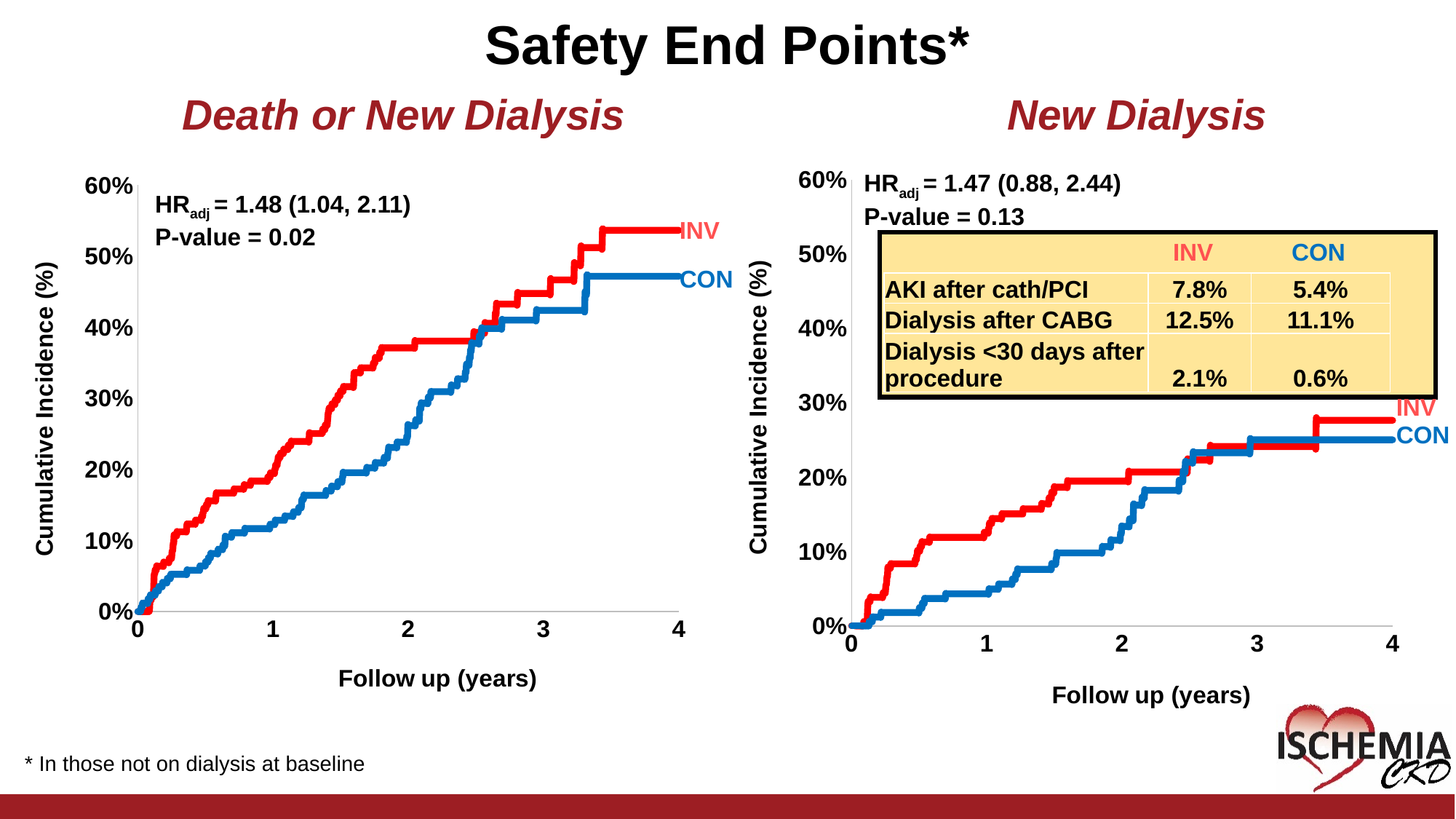
In the table on the 'New Dialysis' chart, what is the difference between INV and CON for Dialysis <30 days after procedure? 1.5% On the 'Death or New Dialysis' chart, do the curves rise or fall as follow-up years increase? rise What is the P-value shown on the 'Death or New Dialysis' chart? 0.02 In the table on the 'New Dialysis' chart, what is the INV value for AKI after cath/PCI? 7.8% How many series are plotted on the 'New Dialysis' chart? 2 On the 'Death or New Dialysis' chart, is the CON value at 4 years greater or less than 50%? less In the table on the 'New Dialysis' chart, what is the CON value for Dialysis after CABG? 11.1% On the 'New Dialysis' chart, is the CON value at 1 year greater or less than 10%? less On the 'Death or New Dialysis' chart, is the INV value at 2 years greater or less than 30%? greater What kind of chart is the 'Death or New Dialysis' chart? line chart